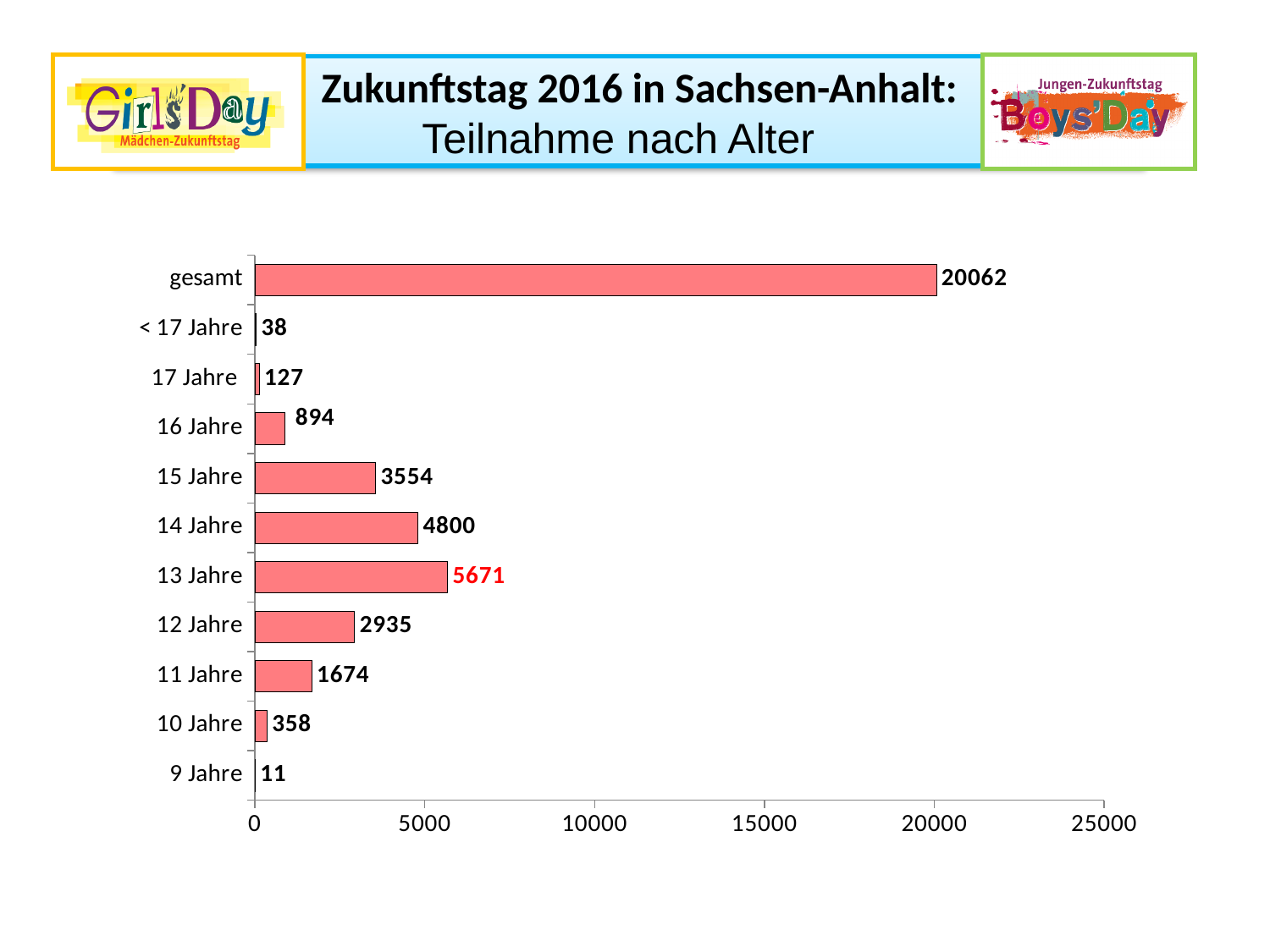
What kind of chart is shown on the slide? bar chart What is the value for 13 Jahre? 5671 What is the value for gesamt? 20062 How many categories are shown on the chart? 11 What is the difference between the values for 16 Jahre and 17 Jahre? 767 Which data label on the chart is printed in red? 5671 Which category has the lowest value? 9 Jahre What is the difference between the values for 14 Jahre and 15 Jahre? 1246 What is the value for 10 Jahre? 358 Which age category (excluding gesamt) has the highest value? 13 Jahre Which is larger, the value for 12 Jahre or the value for 11 Jahre? 12 Jahre Is the value for 14 Jahre greater or less than 5000? less